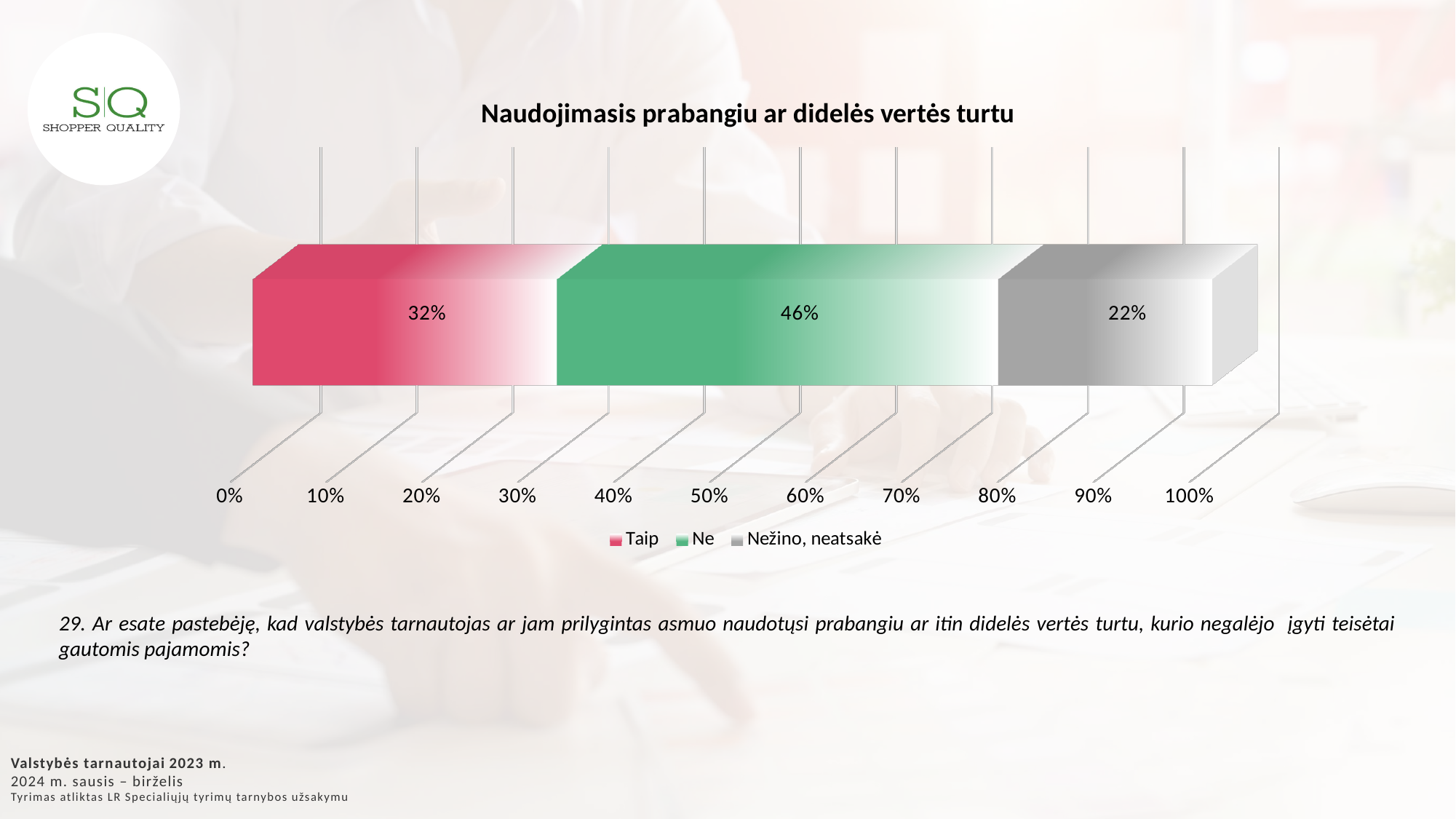
What is the value for "Ne"? 46% What is the total of the stacked bar? 100% How many series does the legend list? 3 What is the value for "Taip"? 32% What kind of chart is shown on the slide? Stacked bar chart Is the value for "Ne" greater or less than 40%? greater Which is larger, the value for "Taip" or the value for "Nežino, neatsakė"? Taip Which series has the lowest value? Nežino, neatsakė Which series has the highest value? Ne What is the title of the chart? Naudojimasis prabangiu ar didelės vertės turtu What is the difference between the values for "Ne" and "Taip"? 14% What is the value for "Nežino, neatsakė"? 22%